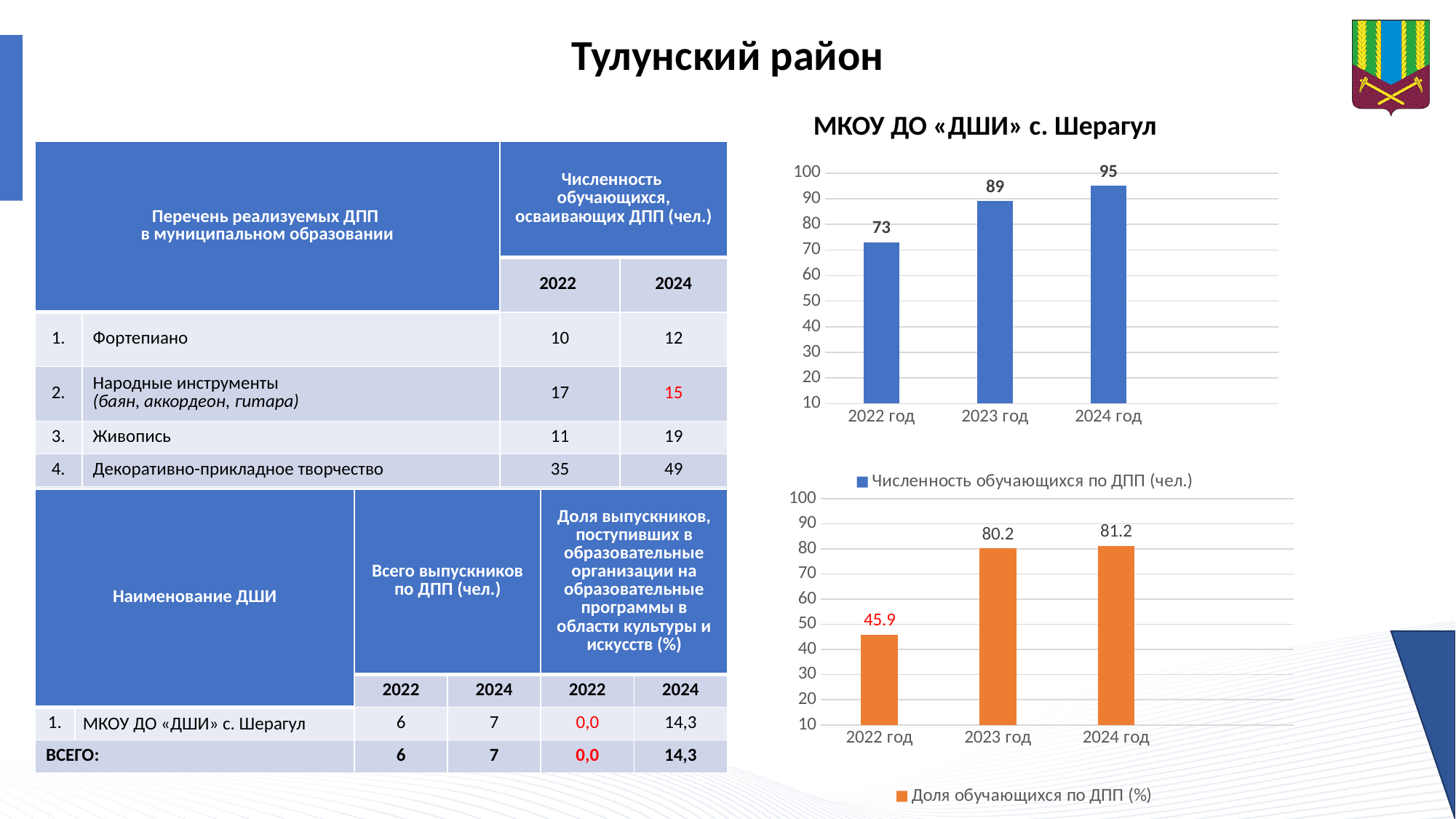
In the top chart (Численность обучающихся по ДПП), what is the value for 2023 год? 89 In the top chart (Численность обучающихся по ДПП), what is the value for 2022 год? 73 In the top chart (Численность обучающихся по ДПП), how many years are plotted? 3 In the bottom chart (Доля обучающихся по ДПП), what is the value for 2022 год? 45.9 In the bottom chart (Доля обучающихся по ДПП), which is larger: the value for 2023 год or the value for 2022 год? 2023 год In the bottom chart (Доля обучающихся по ДПП), what is the value for 2024 год? 81.2 In the top chart (Численность обучающихся по ДПП), which year has the highest value? 2024 год In the top chart (Численность обучающихся по ДПП), what is the difference between the values for 2024 год and 2022 год? 22 In the top chart (Численность обучающихся по ДПП), do the values rise or fall from 2022 год to 2024 год? rise What kind of chart is the bottom chart (Доля обучающихся по ДПП)? bar chart What colour are the bars in the bottom chart (Доля обучающихся по ДПП)? orange In the bottom chart (Доля обучающихся по ДПП), which year has the lowest value? 2022 год